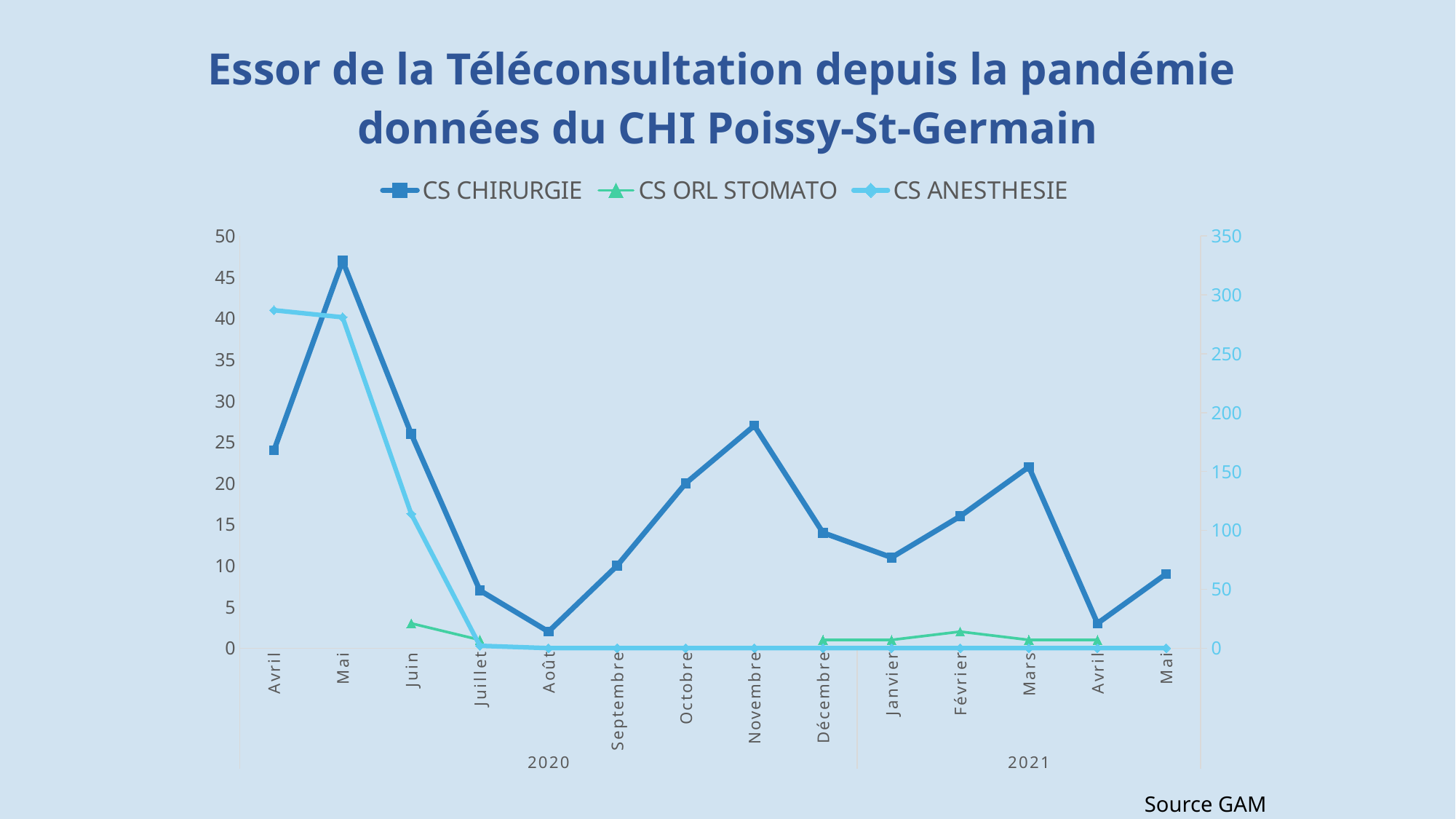
Which is larger for CS CHIRURGIE: Octobre 2020 or Décembre 2020? Octobre 2020 Is the CS CHIRURGIE value for Novembre 2020 greater or less than 20? greater Which is larger for CS CHIRURGIE: Février 2021 or Mars 2021? Mars 2021 Is the CS CHIRURGIE value for Mai 2020 greater or less than 40? greater What source is cited at the bottom of the slide? Source GAM Is the CS CHIRURGIE value for Août 2020 greater or less than 5? less In which month does the CS CHIRURGIE series reach its highest value? Mai 2020 How many months are plotted along the x axis? 14 What kind of chart is shown on the slide? line chart How many series does the legend list? 3 Does the CS CHIRURGIE series rise or fall from Août 2020 to Novembre 2020? rise Does the CS ANESTHESIE series rise or fall from Avril 2020 to Juillet 2020? fall